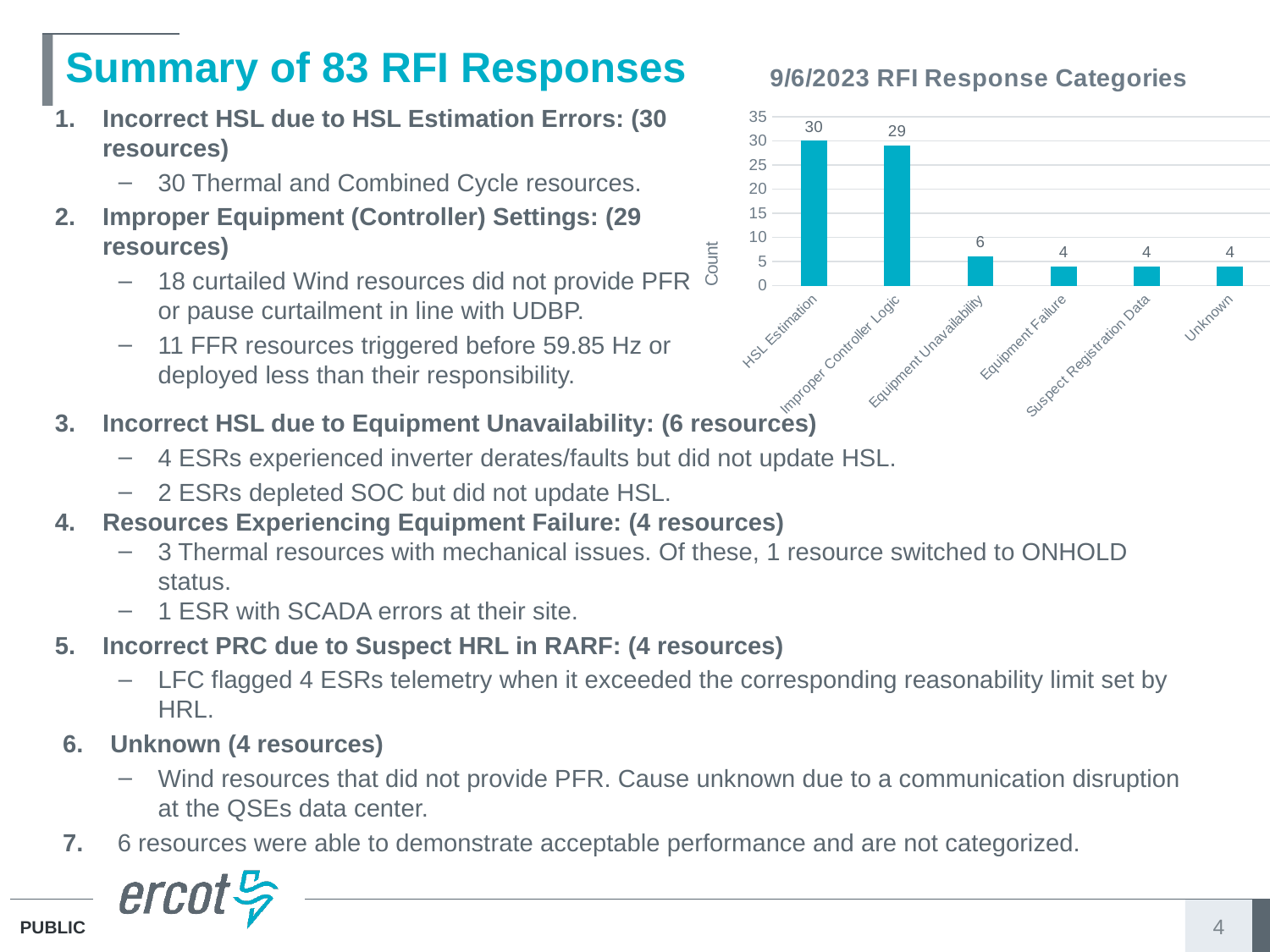
What is the value for Equipment Unavailability in the chart? 6 How many categories are shown in the chart? 6 What is the value for Improper Controller Logic in the chart? 29 What is the difference between the counts for Improper Controller Logic and Unknown? 25 Which category has the highest count in the chart? HSL Estimation Is the value for Improper Controller Logic greater or less than 25? greater What is the difference between the counts for HSL Estimation and Equipment Unavailability? 24 What is the value for Suspect Registration Data in the chart? 4 What is the title of the chart? 9/6/2023 RFI Response Categories What is the value for HSL Estimation in the chart? 30 What kind of chart is shown on the slide? bar chart Which is larger, the count for Equipment Unavailability or the count for Equipment Failure? Equipment Unavailability